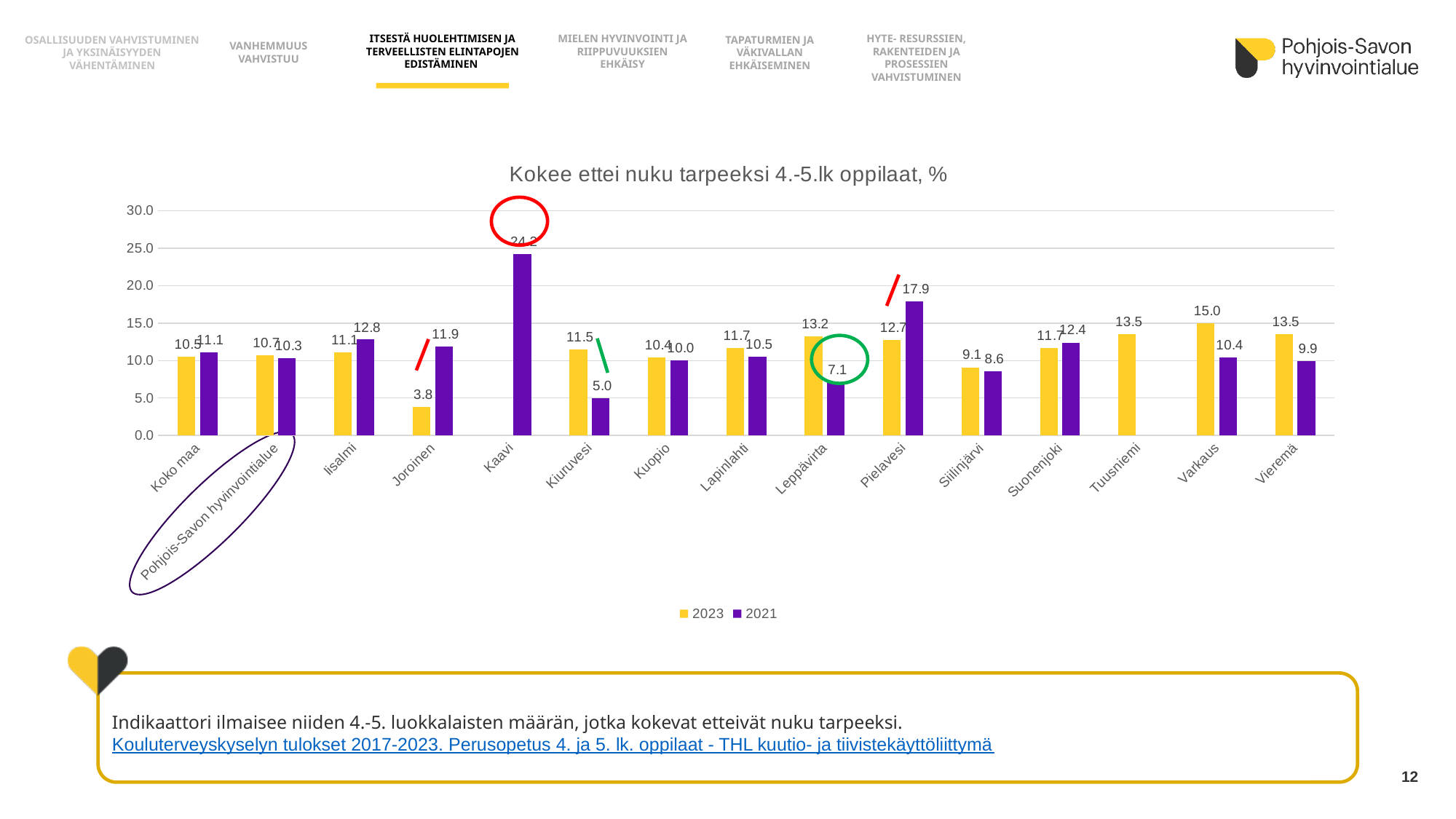
What is the 2023 value for Joroinen? 3.8 How many categories are shown on the x axis? 15 Which is larger for Iisalmi, the 2023 value or the 2021 value? 2021 Which category has the lowest 2023 value? Joroinen What kind of chart is shown on the slide? Bar chart Which category has the highest 2021 value? Kaavi What is the 2021 value for Pielavesi? 17.9 How many series does the legend list? 2 Which category has the highest 2023 value? Varkaus What is the 2023 value for Leppävirta? 13.2 What is the 2021 value for Kiuruvesi? 5.0 What is the difference between the 2023 and 2021 values for Varkaus? 4.6